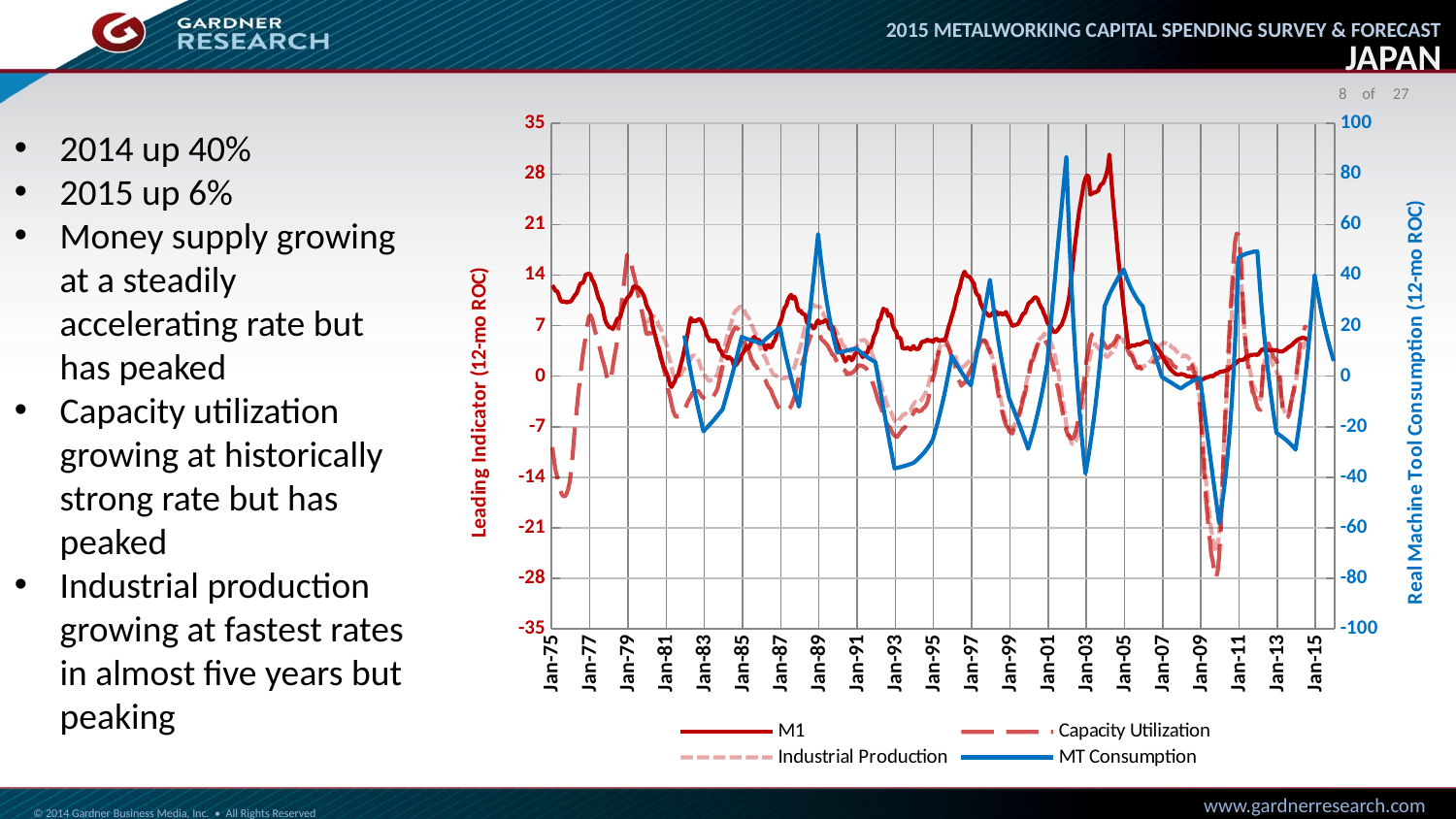
Is the lowest value of the Capacity Utilization series around Jan-09 greater or less than -21 on the left axis? less Is the value of the M1 series at Jan-75 greater or less than 7 on the left axis? greater What is the last year label shown on the x axis of the chart? Jan-15 Is the peak value of the MT Consumption series around Jan-01 to Jan-02 greater or less than 60 on the right axis? greater What is the title of the left vertical axis of the chart? Leading Indicator (12-mo ROC) What kind of chart is shown on the slide? Line chart What is the title of the right vertical axis of the chart? Real Machine Tool Consumption (12-mo ROC) What is the first year label shown on the x axis of the chart? Jan-75 How many series does the chart's legend list? 4